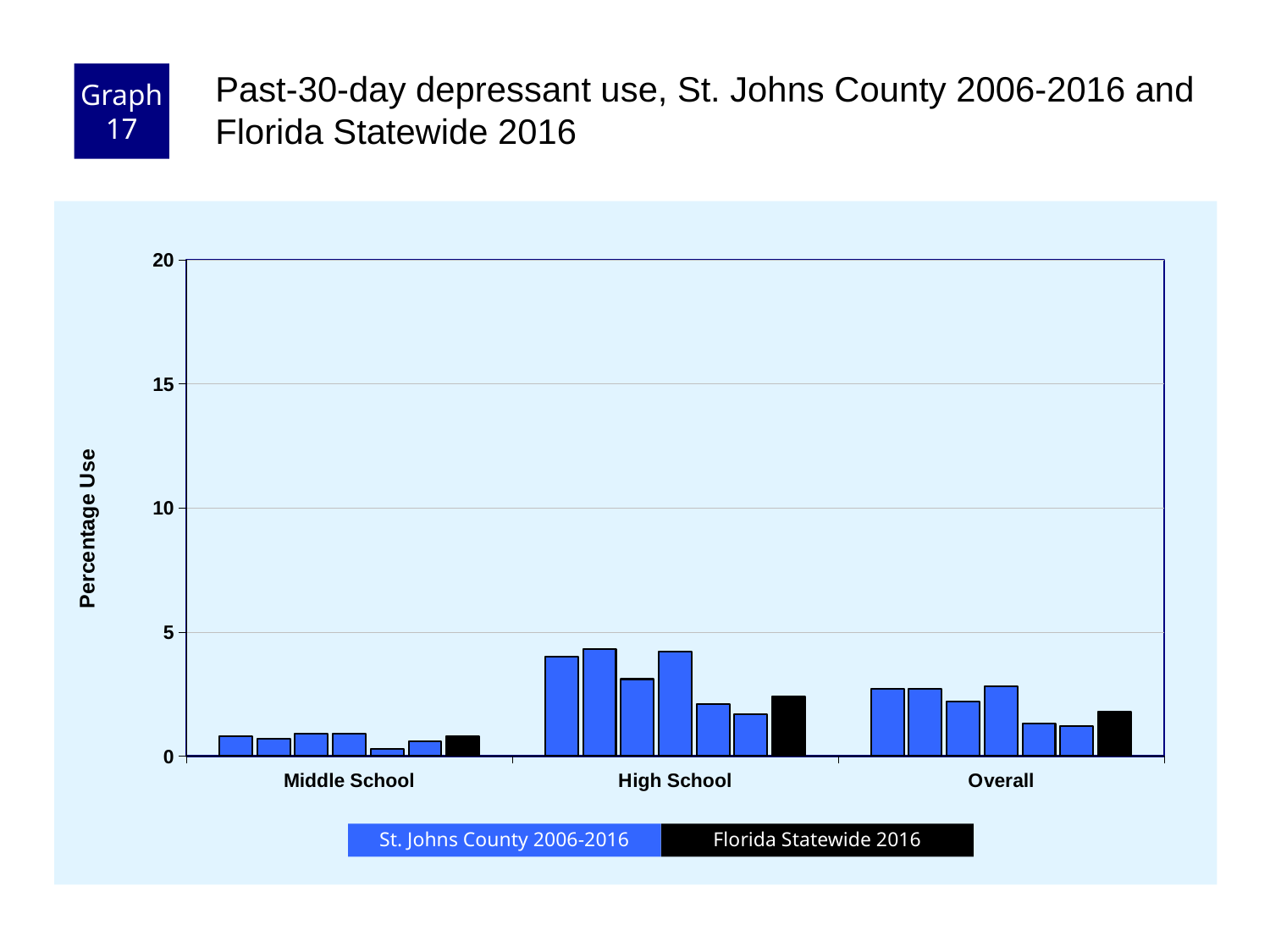
How many series does the legend list? 2 Which category has the highest bars overall? High School What kind of chart is shown on the slide? bar chart How many categories are shown on the x axis? 3 Which category has the lowest bars overall? Middle School Which is larger, the Florida Statewide 2016 bar for High School or the Florida Statewide 2016 bar for Middle School? High School Is the Florida Statewide 2016 value for Middle School greater or less than 5? less What is the label on the y axis? Percentage Use Which is larger, the Florida Statewide 2016 bar for Overall or the Florida Statewide 2016 bar for Middle School? Overall Is the Florida Statewide 2016 value for High School greater or less than 5? less Are all the bars in the chart below 5 on the Percentage Use axis? yes Which colour represents Florida Statewide 2016 in the legend? black